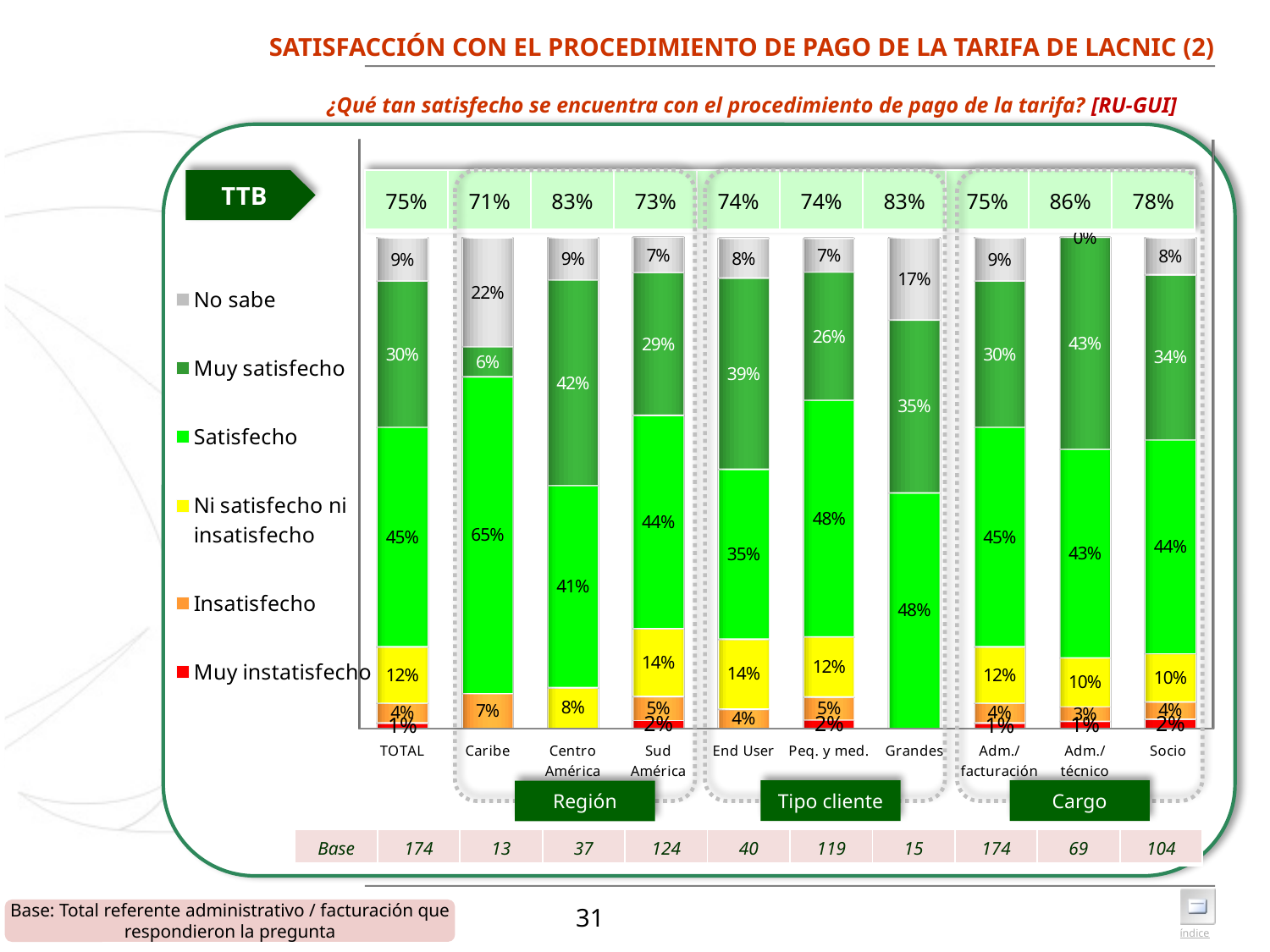
How many categories (bars) are plotted along the x axis? 10 Which category has the lowest Muy satisfecho value? Caribe What is the Satisfecho value for TOTAL? 45% Which category has the highest TTB value shown above the bars? Adm./técnico What kind of chart is shown on the slide? stacked bar chart What is the difference between the Satisfecho values for Caribe and End User? 30% What is the Ni satisfecho ni insatisfecho value for Sud América? 14% What is the No sabe value for Caribe? 22% What is the Muy satisfecho value for Centro América? 42% Which is larger, the Muy satisfecho value for Grandes or for Socio? Grandes Which category has the highest Satisfecho value? Caribe How many series does the legend list? 6